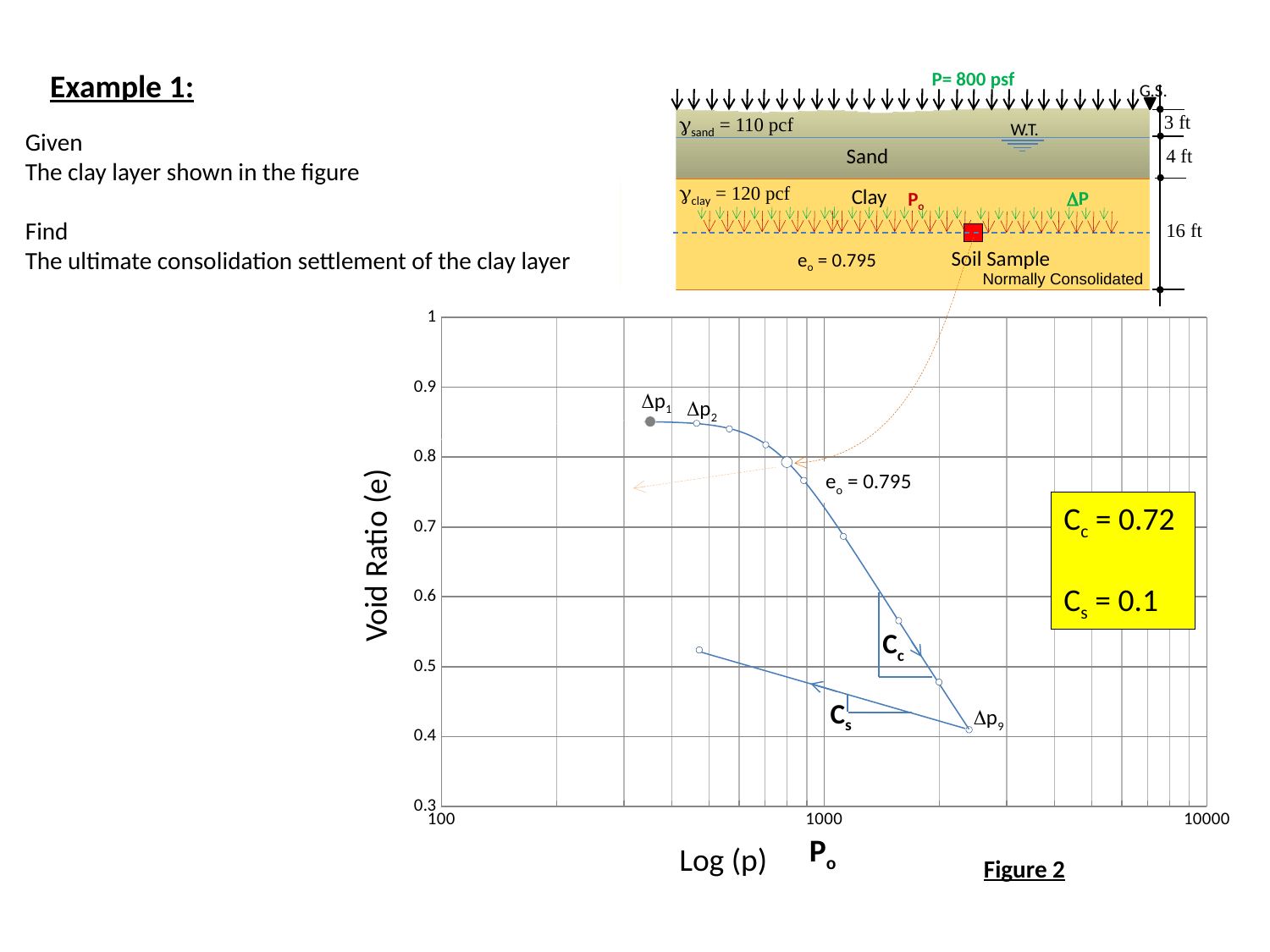
What is the label of the horizontal axis of the chart? Log (p) Is the void ratio at the point labelled Δp1 greater or less than 0.8? greater Which labelled point has the higher void ratio, Δp1 or Δp9? Δp1 What is the initial void ratio e_o marked on the chart? 0.795 What is the highest value shown on the vertical axis of the chart? 1 Is the pressure at the point labelled Δp9 greater or less than 1000? greater What value of the swelling index C_s is given on the chart? 0.1 What value of the compression index C_c is given on the chart? 0.72 Along the main curve, does the void ratio rise or fall as the pressure p increases? fall What kind of chart is shown on the slide? line chart Is the void ratio at the point labelled Δp9 greater or less than 0.5? less What is the label of the vertical axis of the chart? Void Ratio (e)